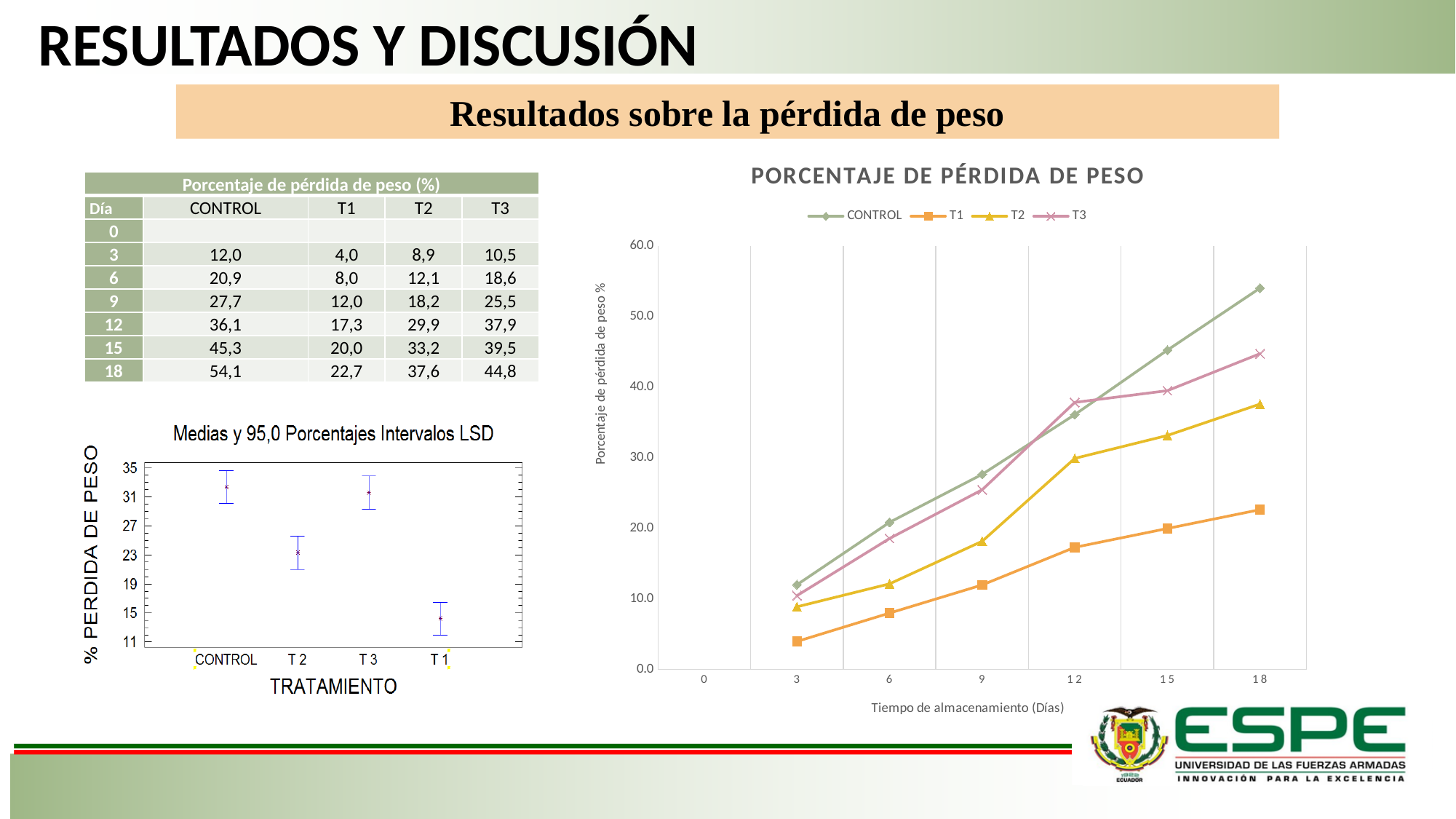
According to the slide, what is the percentage of weight loss for CONTROL at day 18? 54,1 What kind of chart is 'PORCENTAJE DE PÉRDIDA DE PESO'? line chart How many day values are shown on the x axis of the 'PORCENTAJE DE PÉRDIDA DE PESO' chart? 7 In the 'PORCENTAJE DE PÉRDIDA DE PESO' chart, do the values rise or fall as the storage days increase? rise In the 'PORCENTAJE DE PÉRDIDA DE PESO' chart, is the T1 value at day 18 greater or less than 30.0? less In the 'PORCENTAJE DE PÉRDIDA DE PESO' chart, which series has the lowest value at day 18? T1 According to the slide, what is the difference between the CONTROL and T1 weight loss percentages at day 18? 31,4 What is the x-axis title of the 'PORCENTAJE DE PÉRDIDA DE PESO' chart? Tiempo de almacenamiento (Días) In the 'PORCENTAJE DE PÉRDIDA DE PESO' chart, which is larger at day 15, T2 or T1? T2 In the 'PORCENTAJE DE PÉRDIDA DE PESO' chart, which series has the highest value at day 18? CONTROL How many series does the legend of the 'PORCENTAJE DE PÉRDIDA DE PESO' chart list? 4 In the 'PORCENTAJE DE PÉRDIDA DE PESO' chart, is the CONTROL value at day 18 greater or less than 50.0? greater